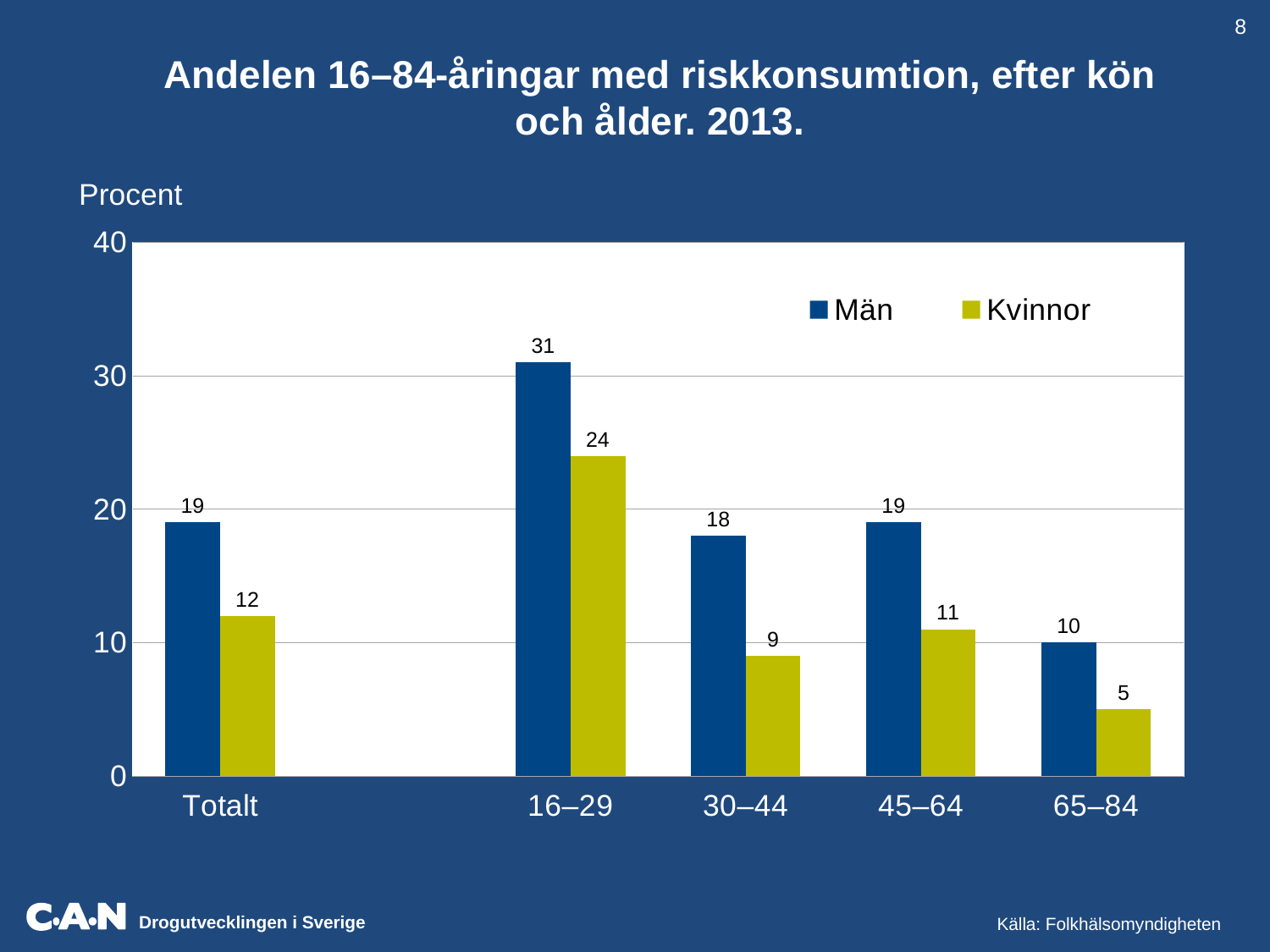
How many categories are shown on the x axis? 5 What is the label on the y axis? Procent Which age group has the highest value for Män? 16–29 What kind of chart is shown on the slide? Bar chart Which category has the lowest value for Kvinnor? 65–84 What is the value for Män in the 16–29 age group? 31 What is the value for Kvinnor in the 65–84 age group? 5 What is the value for Kvinnor in the Totalt category? 12 Is the value for Kvinnor in the 16–29 age group greater or less than 20? greater Which is larger in the 45–64 age group, Män or Kvinnor? Män What is the difference between Män and Kvinnor in the 30–44 age group? 9 How many series does the legend list? 2